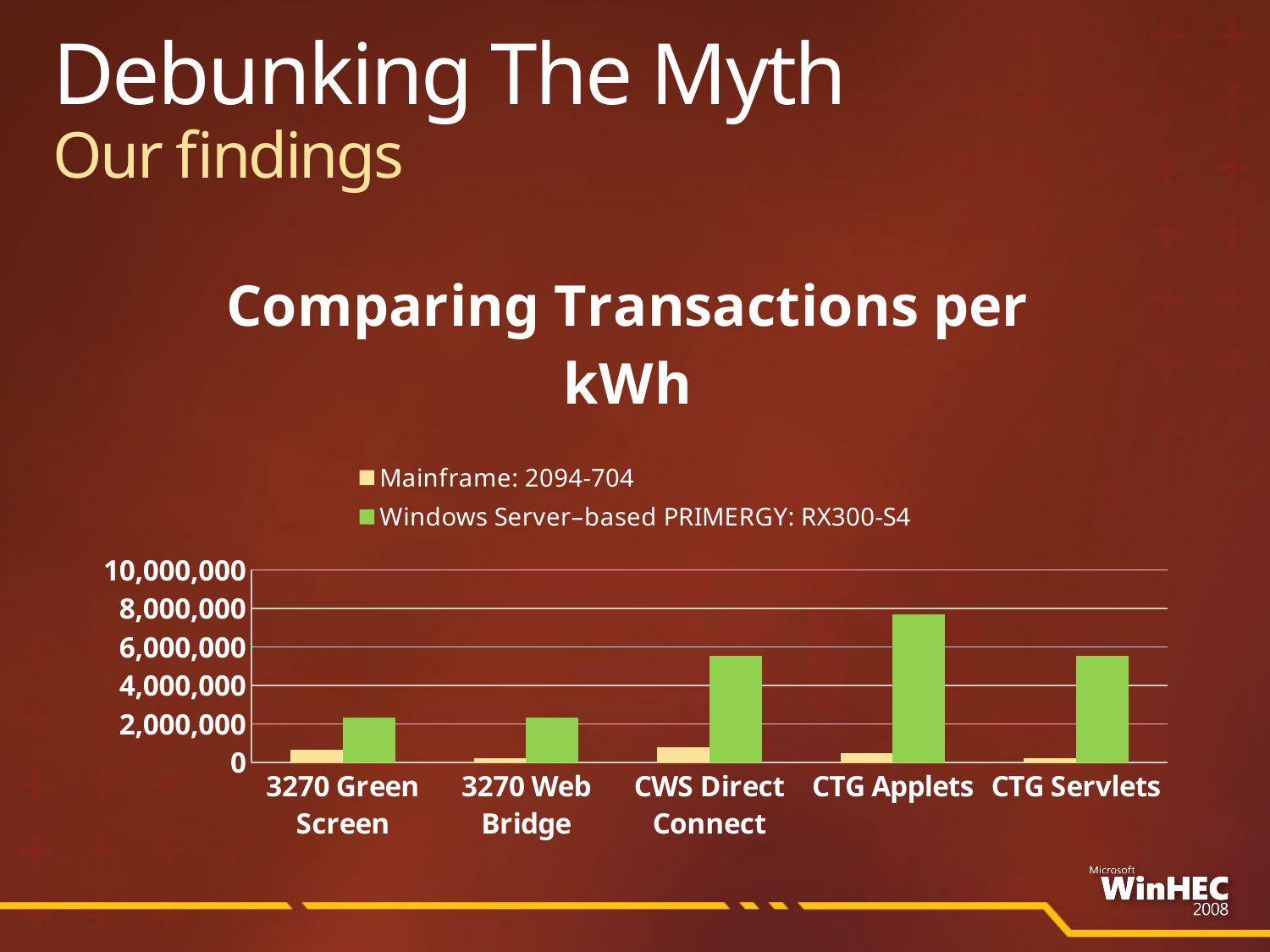
For CTG Applets, which series has the larger value: Mainframe: 2094-704 or Windows Server–based PRIMERGY: RX300-S4? Windows Server–based PRIMERGY: RX300-S4 Is the Mainframe: 2094-704 value for 3270 Green Screen greater or less than 2,000,000? less Which category has the highest value for the Windows Server–based PRIMERGY: RX300-S4 series? CTG Applets Is the Windows Server–based PRIMERGY: RX300-S4 value for CWS Direct Connect greater or less than 4,000,000? greater How many categories are shown on the x axis? 5 What is the title of the chart? Comparing Transactions per kWh For the Windows Server–based PRIMERGY: RX300-S4 series, which is larger: CTG Applets or CTG Servlets? CTG Applets Is the Windows Server–based PRIMERGY: RX300-S4 value for CTG Applets greater or less than 6,000,000? greater What kind of chart is shown on the slide? bar chart Which series is shown in green in the legend? Windows Server–based PRIMERGY: RX300-S4 How many series does the legend list? 2